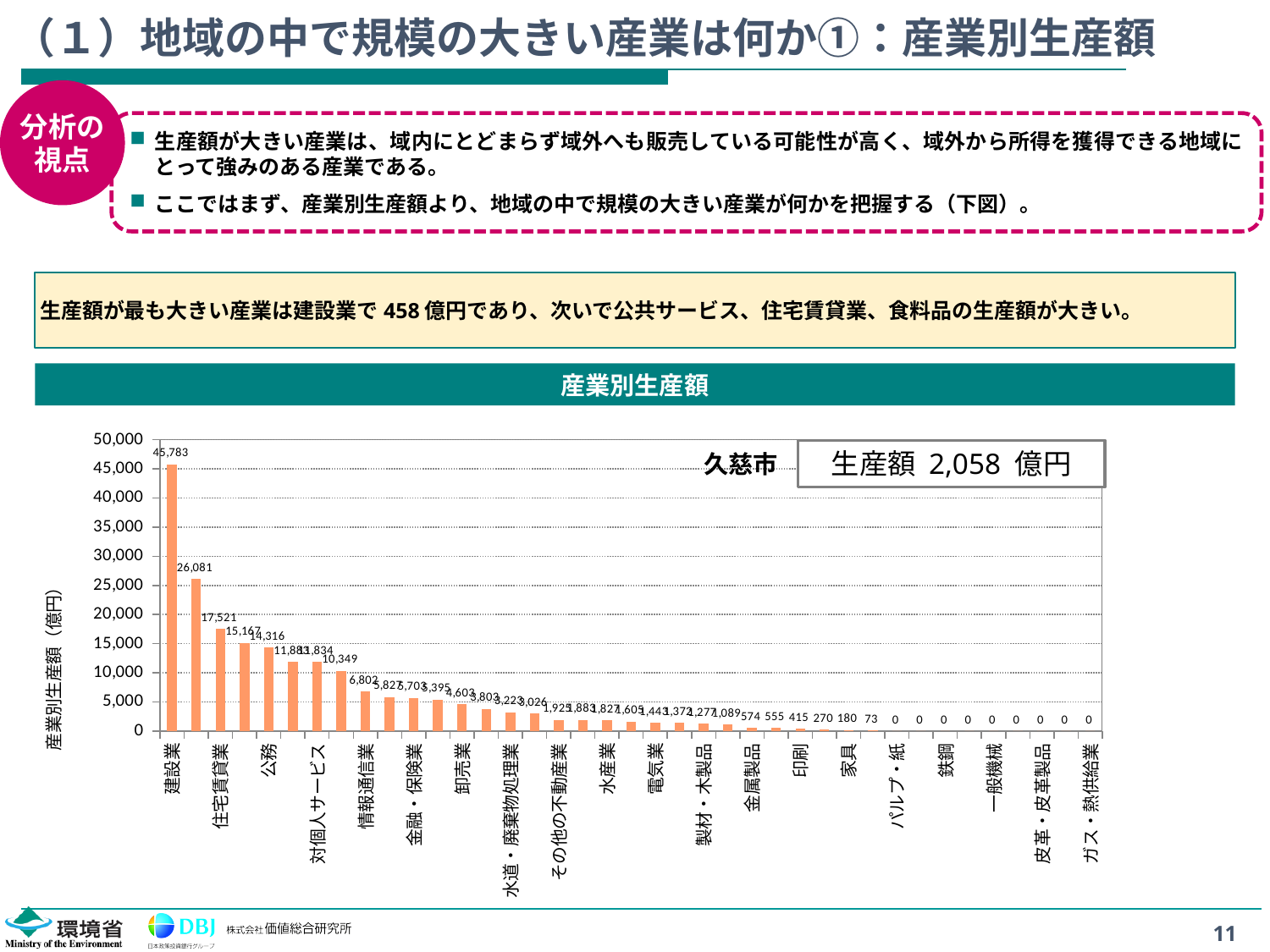
What is the value for 家具 in the 産業別生産額 chart? 180 What kind of chart is the 産業別生産額 chart? bar chart Which is larger in the 産業別生産額 chart, the value for 公務 or the value for 卸売業? 公務 Do the values in the 産業別生産額 chart rise or fall from left to right along the x axis? fall What is the value for 住宅賃貸業 in the 産業別生産額 chart? 17,521 Is the value for 建設業 in the 産業別生産額 chart greater or less than 40,000? greater What is the difference between the values for 建設業 and 住宅賃貸業 in the 産業別生産額 chart? 28,262 Which industry has the highest value in the 産業別生産額 chart? 建設業 What is the value for 公務 in the 産業別生産額 chart? 14,316 What is the value for 情報通信業 in the 産業別生産額 chart? 6,802 What total 生産額 is shown in the box at the top right of the 産業別生産額 chart? 2,058 億円 What is the value for 建設業 in the 産業別生産額 chart? 45,783